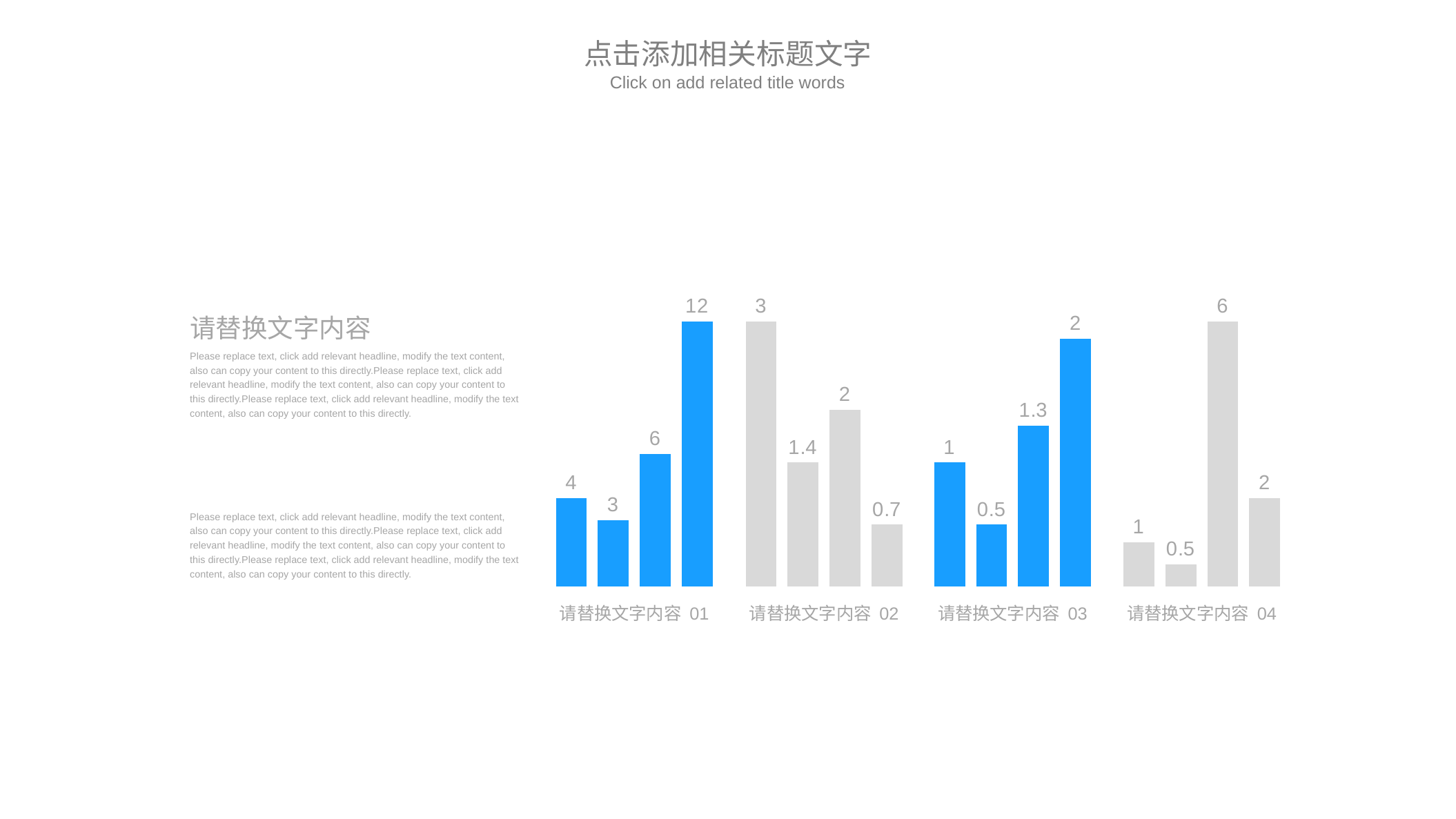
What is the total of the four bars in the group labelled 请替换文字内容 03? 4.8 What is the value of the tallest bar in the group labelled 请替换文字内容 01? 12 What colour are the bars in the groups labelled 请替换文字内容 01 and 请替换文字内容 03? blue Which bar in the group labelled 请替换文字内容 02 has the lowest value? the fourth bar (0.7) What is the value of the second bar in the group labelled 请替换文字内容 03? 0.5 How many bars are in each category group of the chart? 4 What is the value of the third bar in the group labelled 请替换文字内容 04? 6 What is the value of the first bar in the group labelled 请替换文字内容 02? 3 How many category groups are shown along the x axis of the chart? 4 What kind of chart is shown on the slide? bar chart What is the difference between the highest and lowest bars in the group labelled 请替换文字内容 01? 9 Which is larger: the third bar in group 请替换文字内容 03 or the second bar in group 请替换文字内容 02? the second bar in group 请替换文字内容 02 (1.4)